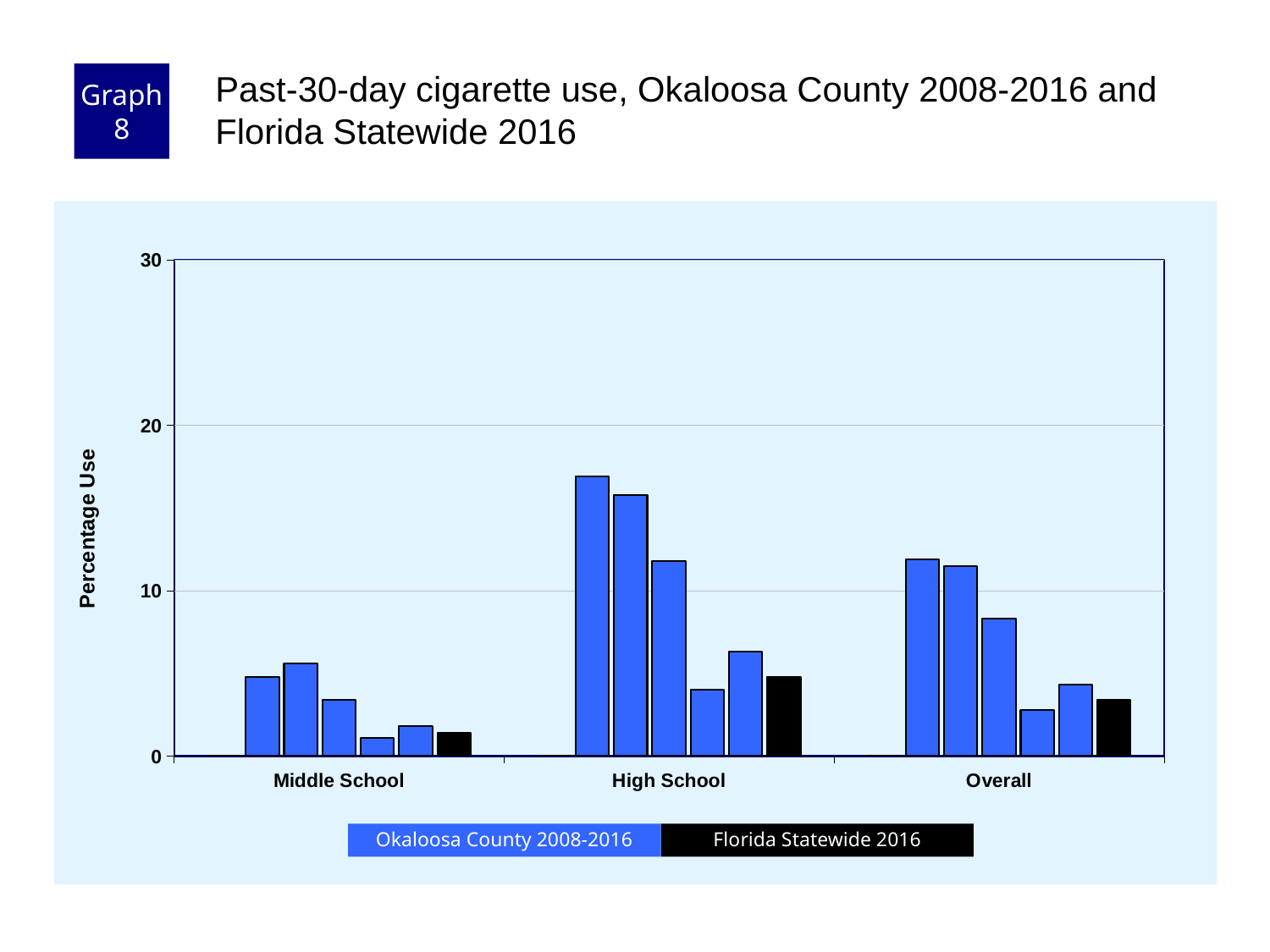
What is the label of the y axis? Percentage Use Is the tallest Okaloosa County bar for Overall greater or less than 10? greater Is the tallest Okaloosa County bar for High School greater or less than 10? greater Which category has the highest Florida Statewide 2016 value? High School Is the tallest Okaloosa County bar for Middle School greater or less than 10? less What kind of chart is shown on the slide? bar chart Is the Florida Statewide 2016 value larger for High School or for Middle School? High School How many categories are shown on the x axis? 3 Which colour represents Florida Statewide 2016 in the legend? black Which category has the lowest Florida Statewide 2016 value? Middle School How many series does the legend list? 2